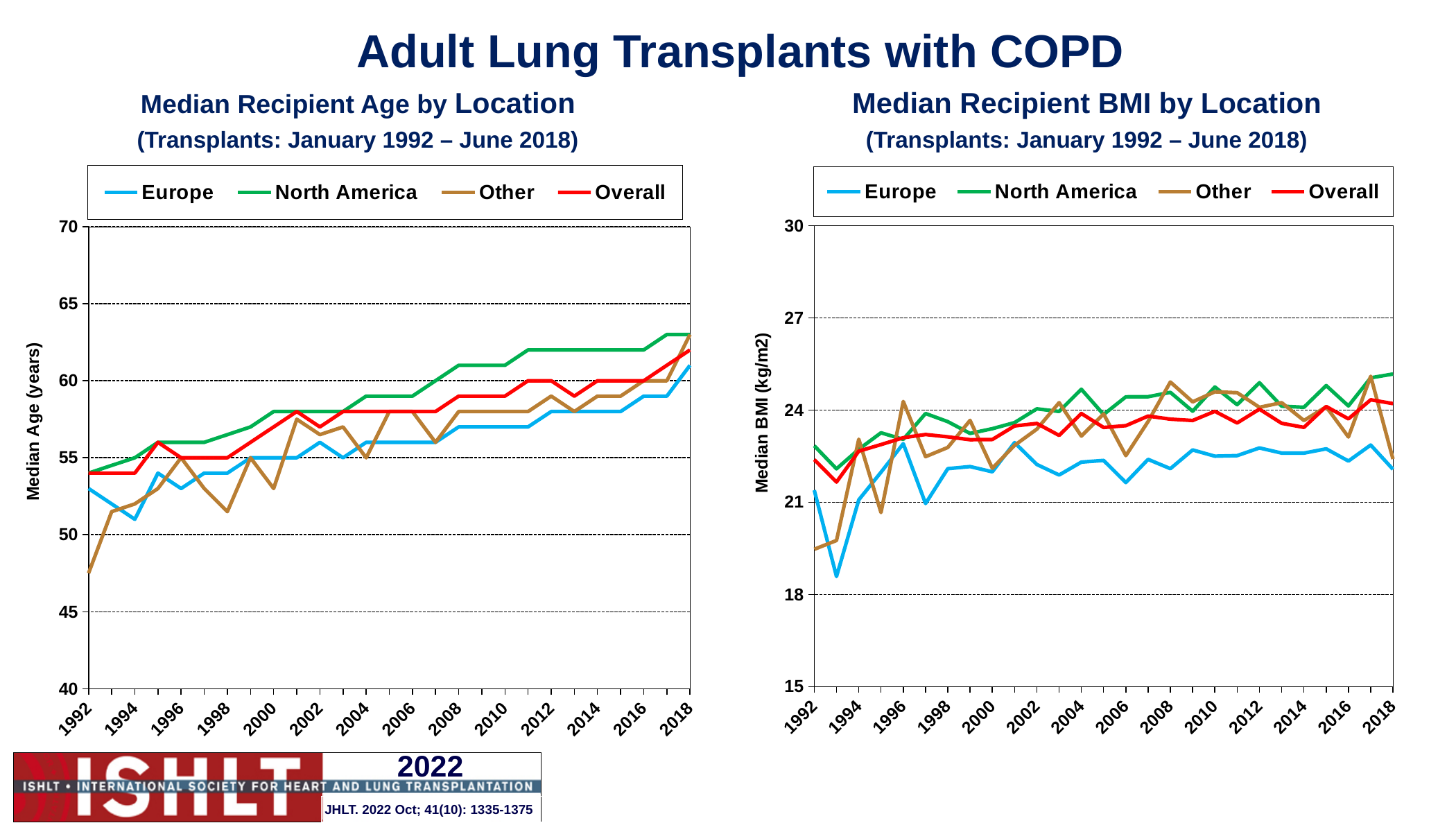
In the Median Recipient Age by Location chart, which series has the lowest value in 1992? Other How many series does the legend of the Median Recipient BMI by Location chart list? 4 In the Median Recipient Age by Location chart, is the Europe value for 1992 greater or less than 55? less In the Median Recipient BMI by Location chart, which series has the highest value in 2018? North America What is the y-axis label of the Median Recipient BMI by Location chart? Median BMI (kg/m2) In the Median Recipient Age by Location chart, is the North America value for 2018 greater or less than 60? greater In the Median Recipient Age by Location chart, what is the Overall median age in 2012? 60 In the Median Recipient BMI by Location chart, which is larger in 2018: North America or Europe? North America In the Median Recipient BMI by Location chart, is the Europe value for 1993 greater or less than 21? less What type of chart is the Median Recipient Age by Location chart? line chart In the Median Recipient BMI by Location chart, which series has the lowest value in 1993? Europe In the Median Recipient Age by Location chart, does the North America series generally rise or fall from 1992 to 2018? rise